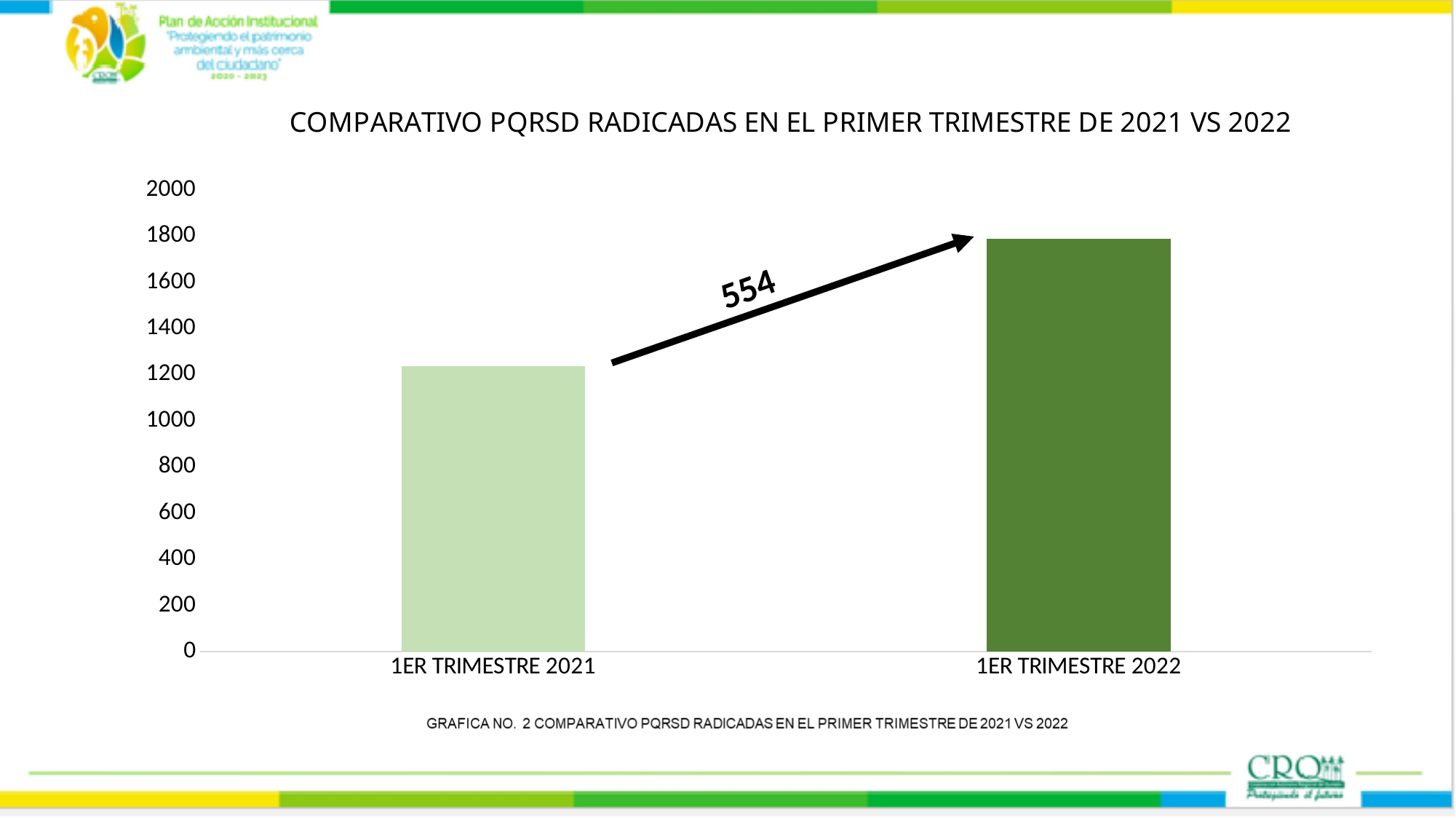
Which category has the lowest value? 1ER TRIMESTRE 2021 Which category has the highest value? 1ER TRIMESTRE 2022 How many categories (bars) does the chart show? 2 Do the values rise or fall from 1ER TRIMESTRE 2021 to 1ER TRIMESTRE 2022? rise Is the value for 1ER TRIMESTRE 2022 greater or less than 2000? less Is the value for 1ER TRIMESTRE 2021 greater or less than 1400? less Which is larger, the value for 1ER TRIMESTRE 2021 or for 1ER TRIMESTRE 2022? 1ER TRIMESTRE 2022 What kind of chart is shown on the slide? bar chart According to the label on the arrow, by how much did the PQRSD increase from the first quarter of 2021 to the first quarter of 2022? 554 Is the value for 1ER TRIMESTRE 2022 greater or less than 1600? greater What is the title of the chart? COMPARATIVO PQRSD RADICADAS EN EL PRIMER TRIMESTRE DE 2021 VS 2022